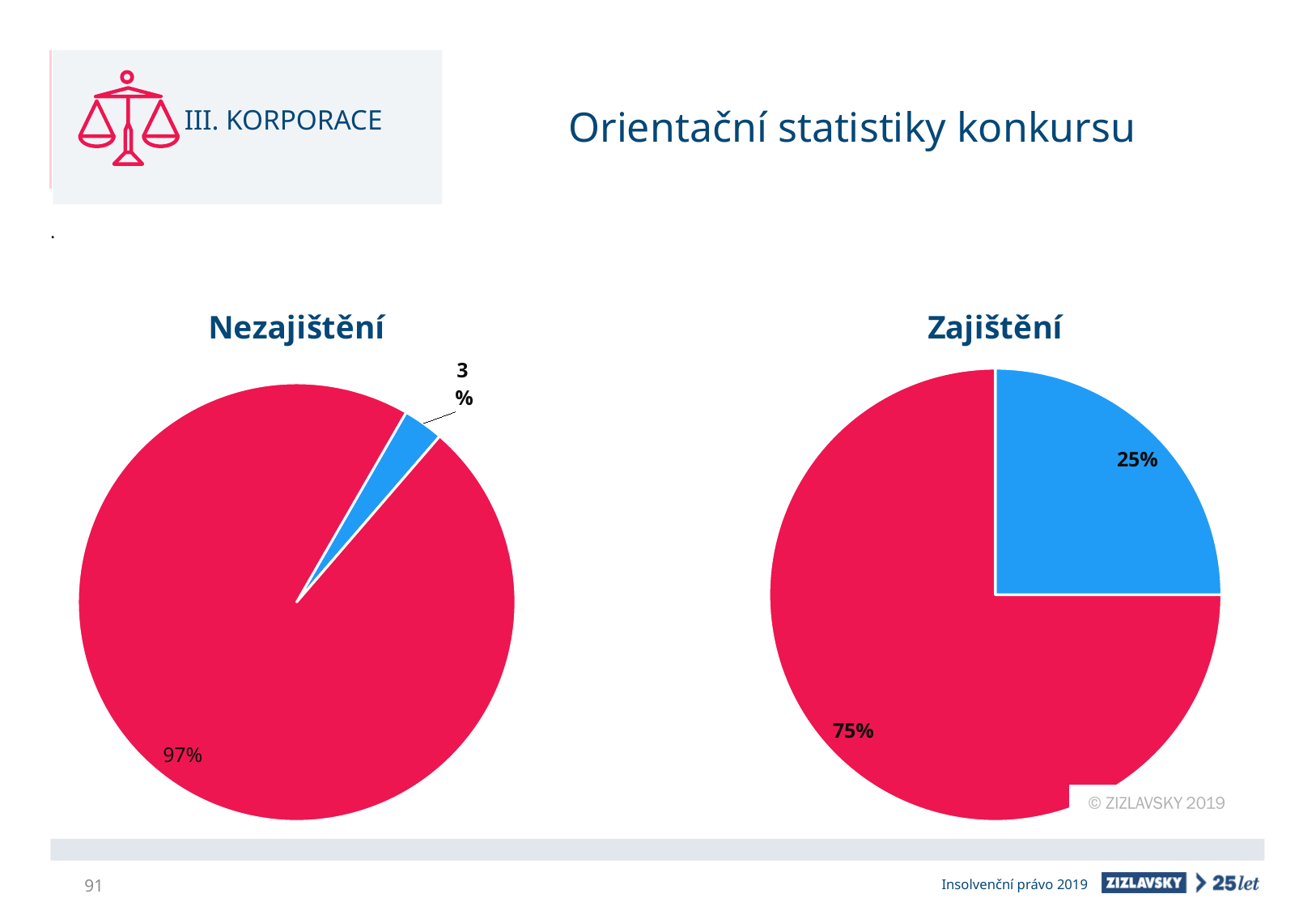
In the "Nezajištění" chart, what share does the red slice have? 97% In the "Zajištění" chart, which slice is the smallest? the blue slice (25%) What kind of chart is the "Nezajištění" chart? pie chart In the "Zajištění" chart, what share does the blue slice have? 25% In the "Nezajištění" chart, which slice is the largest? the red slice (97%) How many slices does the "Zajištění" pie chart have? 2 Which chart has the larger blue slice, "Nezajištění" or "Zajištění"? Zajištění In the "Nezajištění" chart, what share does the blue slice have? 3% In the "Nezajištění" chart, what is the difference between the red and blue slices? 94% What kind of chart is the "Zajištění" chart? pie chart In the "Zajištění" chart, what is the difference between the red and blue slices? 50%